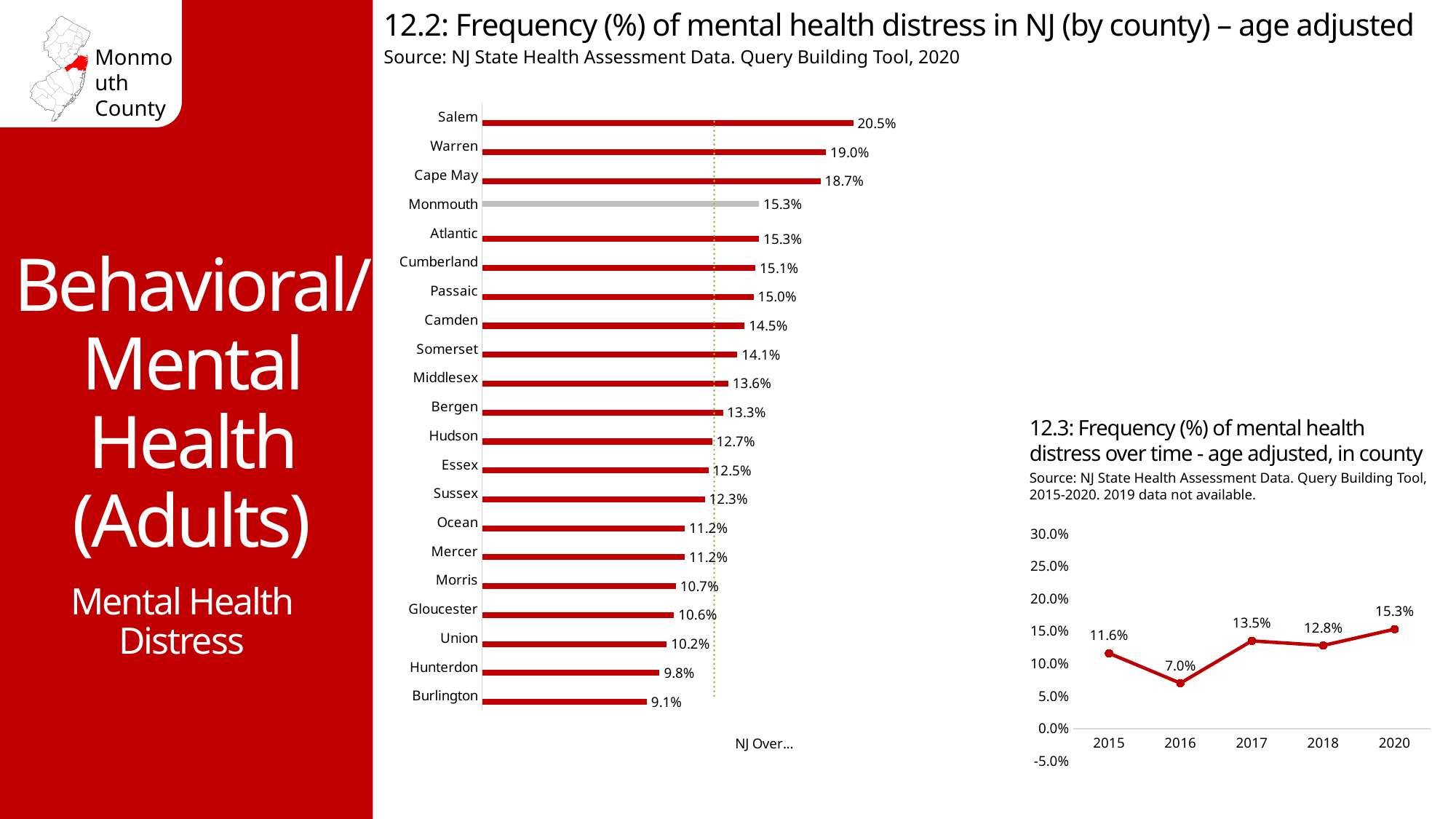
What kind of chart is chart 12.2? Bar chart In chart 12.2, how many counties are shown? 21 In chart 12.2, which county has a larger value, Warren or Cape May? Warren In chart 12.2, which county has the lowest frequency of mental health distress? Burlington In chart 12.3, which year has the highest value? 2020 In chart 12.3, what is the difference between the values for 2017 and 2018? 0.7% In chart 12.2, what is the frequency of mental health distress for Monmouth? 15.3% In chart 12.3, what is the value for 2016? 7.0% In chart 12.2, what is the difference between the values for Salem and Burlington? 11.4% In chart 12.3, how many data points are plotted? 5 In chart 12.2, which county has the highest frequency of mental health distress? Salem In chart 12.2, what is the value for Hunterdon? 9.8%